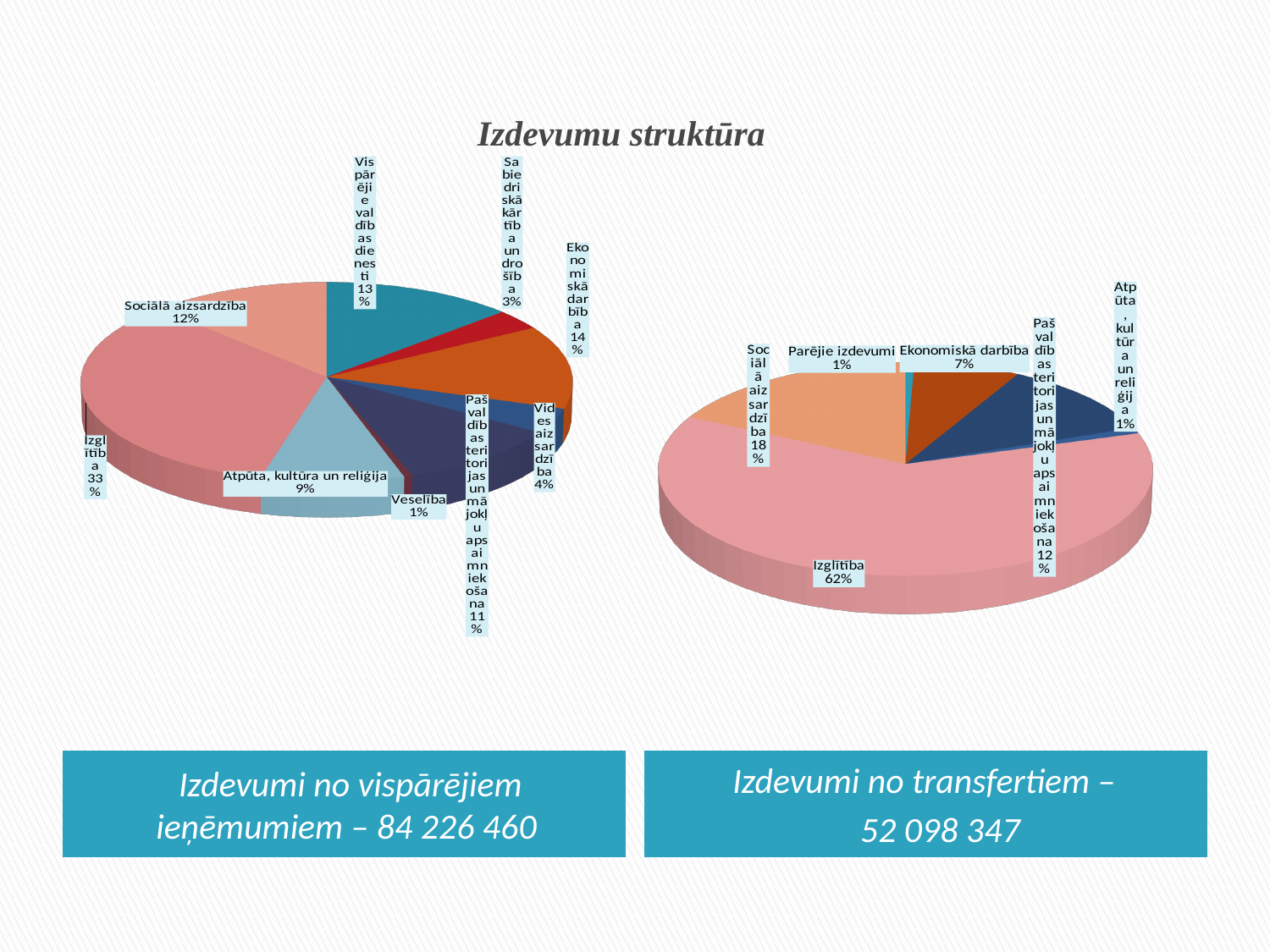
In the right pie chart, which category has the largest share? Izglītība In the right pie chart, which is larger: Ekonomiskā darbība or Pašvaldības teritorijas un mājokļu apsaimniekošana? Pašvaldības teritorijas un mājokļu apsaimniekošana In the left pie chart, what is the difference between the shares of Izglītība and Sociālā aizsardzība? 21 percentage points In the left pie chart, what share does Sociālā aizsardzība have? 12% What type of chart is used on this slide? Pie chart In the right pie chart (Izdevumi no transfertiem), what share does Izglītība have? 62% In the left pie chart, what share does Ekonomiskā darbība have? 14% In the left pie chart, which category has the largest share? Izglītība In the right pie chart, what share does Sociālā aizsardzība have? 18% In the left pie chart, how many slices are there? 9 In the left pie chart, which category has the smallest share? Veselība In the left pie chart (Izdevumi no vispārējiem ieņēmumiem), what share does Izglītība have? 33%